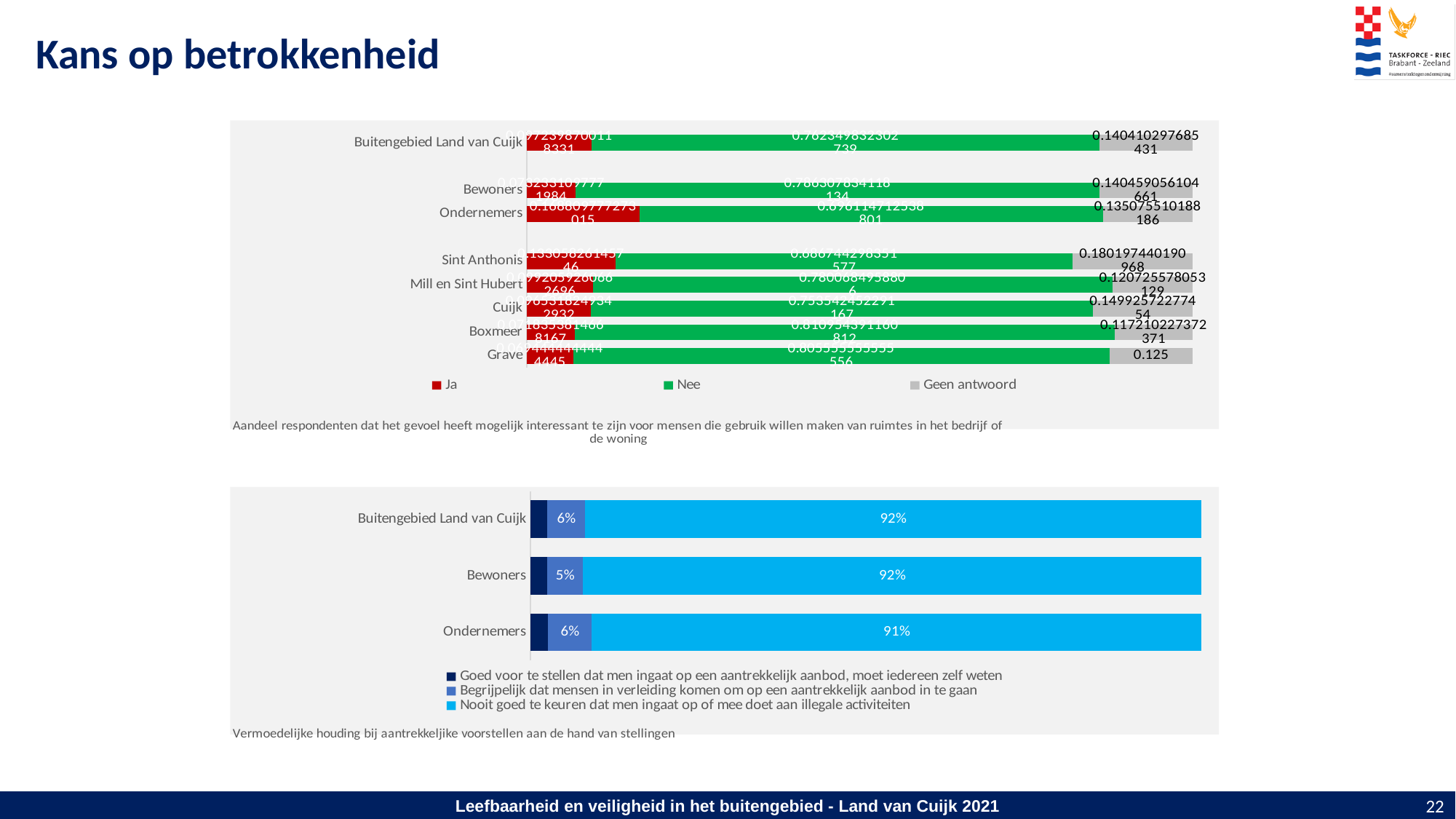
How many categories are shown in the bottom chart? 3 In the bottom chart, which category has the lowest value for 'Nooit goed te keuren dat men ingaat op of mee doet aan illegale activiteiten'? Ondernemers In the bottom chart, what is the value for Bewoners in the series 'Begrijpelijk dat mensen in verleiding komen om op een aantrekkelijk aanbod in te gaan'? 5% In the bottom chart (Vermoedelijke houding bij aantrekkelijke voorstellen), what is the value for Ondernemers in the series 'Nooit goed te keuren dat men ingaat op of mee doet aan illegale activiteiten'? 91% How many categories are shown in the top chart? 8 In the top chart, what is the 'Geen antwoord' value for Grave? 0.125 In the bottom chart, what is the value for Buitengebied Land van Cuijk in the series 'Begrijpelijk dat mensen in verleiding komen om op een aantrekkelijk aanbod in te gaan'? 6% How many series does the legend of the bottom chart list? 3 In the bottom chart, what is the difference between the 'Nooit goed te keuren' value for Buitengebied Land van Cuijk and for Ondernemers? 1 percentage point What kind of chart is the bottom chart? Stacked bar chart How many series does the legend of the top chart list? 3 In the bottom chart, which is larger: the 'Begrijpelijk dat mensen in verleiding komen' value for Bewoners or for Ondernemers? Ondernemers